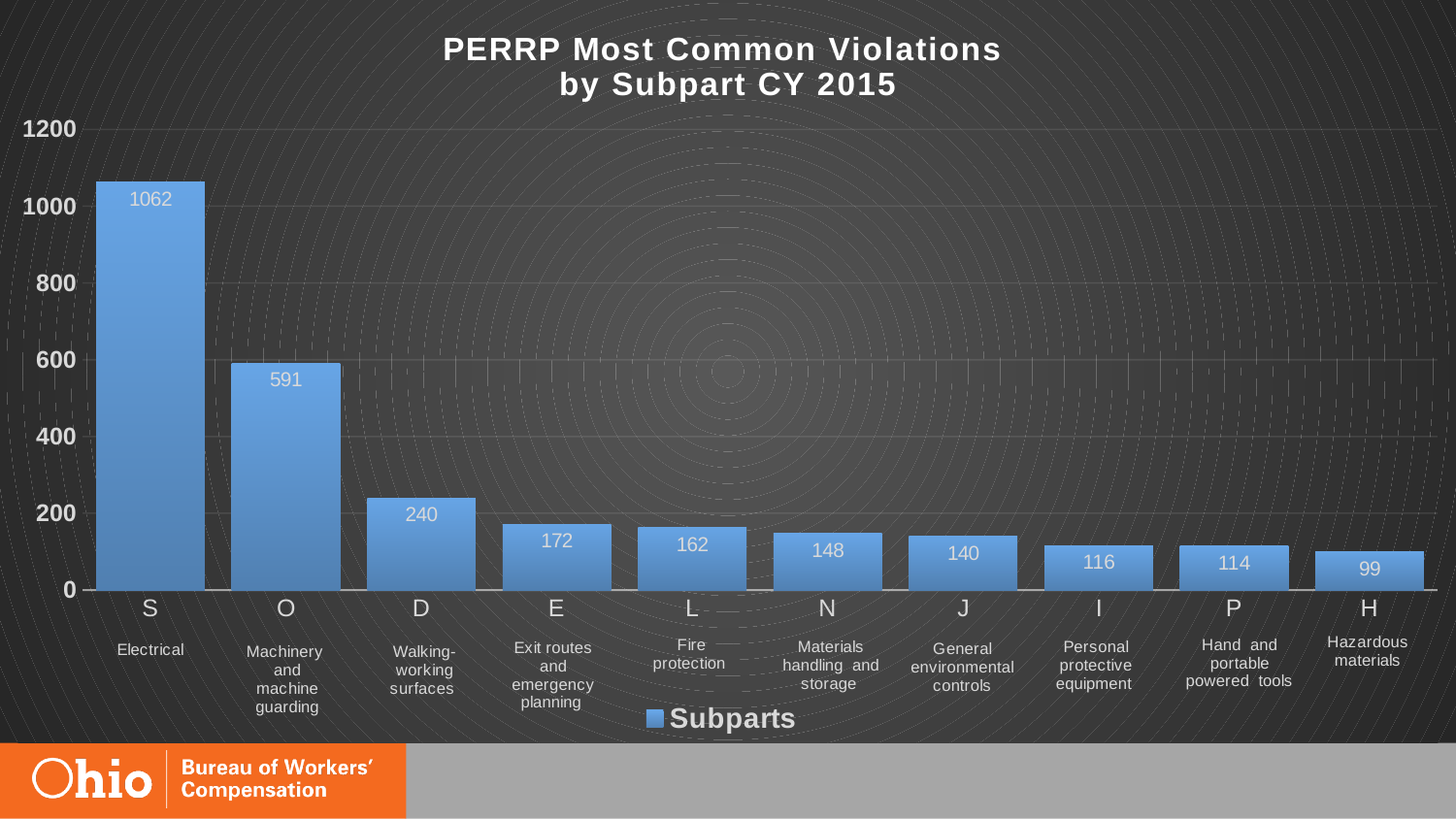
How many subparts are shown on the chart? 10 What is the value for Subpart J (General environmental controls)? 140 What is the value for Subpart S (Electrical)? 1062 Which subpart has the highest number of violations? S (Electrical) What is the difference between the values for Subpart E and Subpart L? 10 What is the difference between the values for Subpart S and Subpart O? 471 Which is larger, the value for Subpart N or the value for Subpart I? Subpart N What is the title of the chart? PERRP Most Common Violations by Subpart CY 2015 Which subpart has the lowest number of violations? H (Hazardous materials) Is the value for Subpart O greater or less than 400? greater What kind of chart is shown on the slide? Bar chart What is the value for Subpart D (Walking-working surfaces)? 240